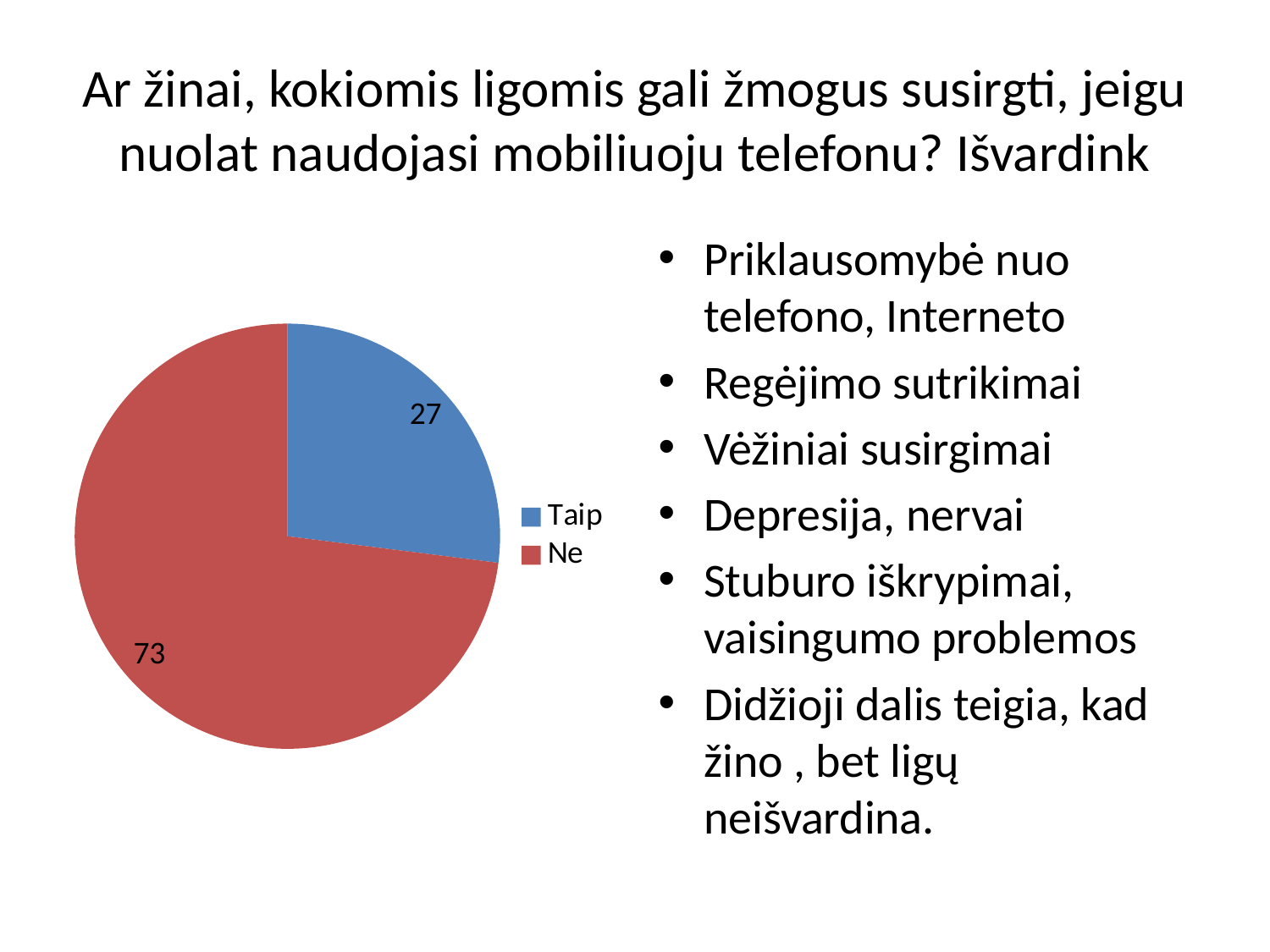
Which category has the largest slice in the pie chart? Ne What share of the pie does the "Taip" slice represent? 27% Which category has the smallest slice in the pie chart? Taip What is the total of all slices in the pie chart? 100 What is the difference between the values for "Ne" and "Taip"? 46 What is the value for "Ne" in the pie chart? 73 Which is larger, the value for "Taip" or the value for "Ne"? Ne What colour is the "Taip" slice in the pie chart? blue How many slices does the pie chart have? 2 What share of the pie does the "Ne" slice represent? 73% What kind of chart is shown on the slide? pie chart What is the value for "Taip" in the pie chart? 27